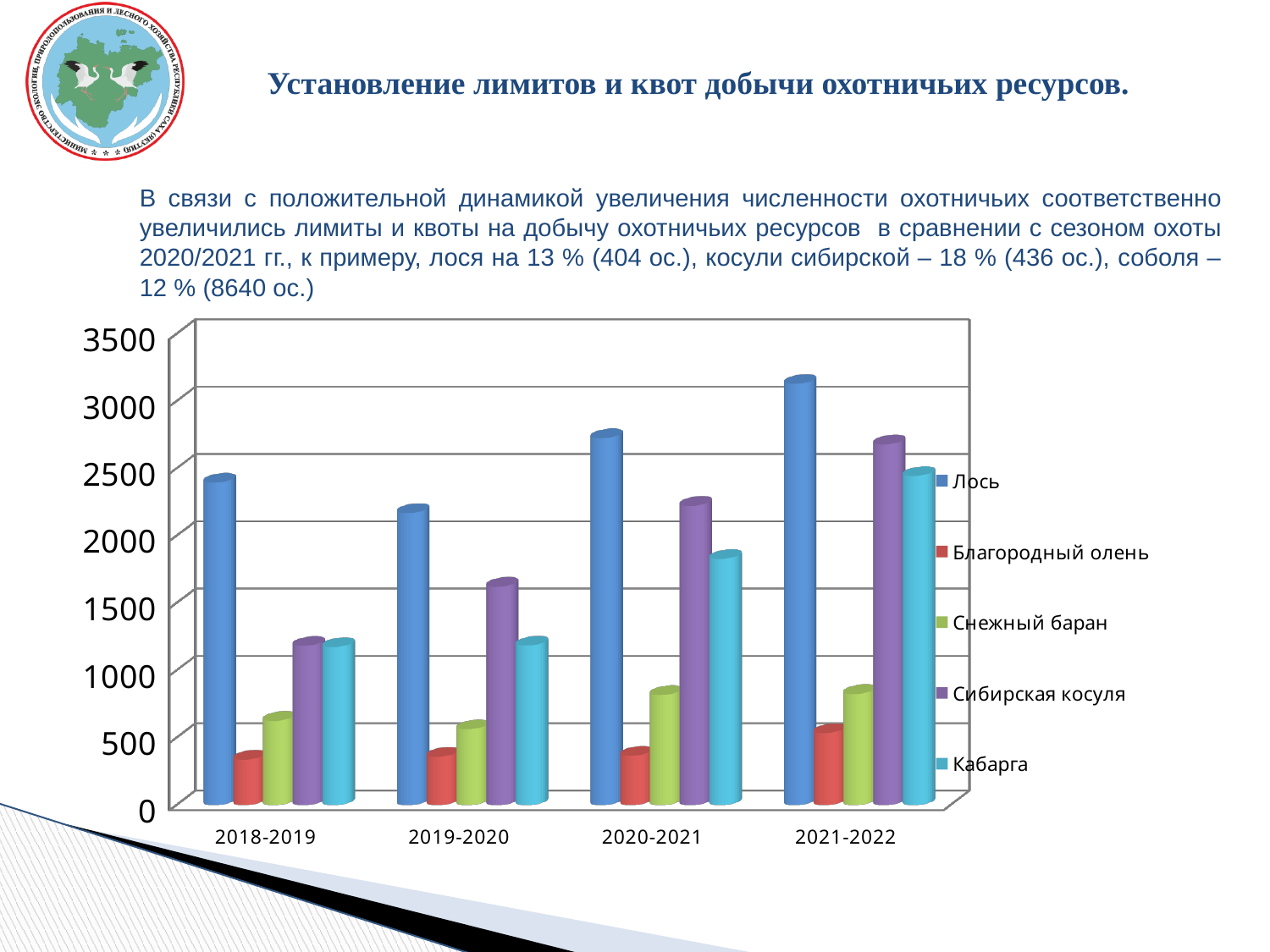
Is the value for Лось in 2021-2022 greater or less than 3000? greater How many hunting seasons are shown on the x axis of the chart? 4 What colour represents Лось in the chart legend? blue In 2020-2021, which is larger: Сибирская косуля or Кабарга? Сибирская косуля Is the value for Сибирская косуля in 2018-2019 greater or less than 1500? less What kind of chart is shown on the slide? bar chart Which series has the lowest value in 2018-2019? Благородный олень In which season is the value for Лось the lowest? 2019-2020 In which season is the value for Лось the highest? 2021-2022 Do the values for Сибирская косуля rise or fall from 2018-2019 to 2021-2022? rise Is the value for Кабарга in 2021-2022 greater or less than 2000? greater How many series does the chart legend list? 5